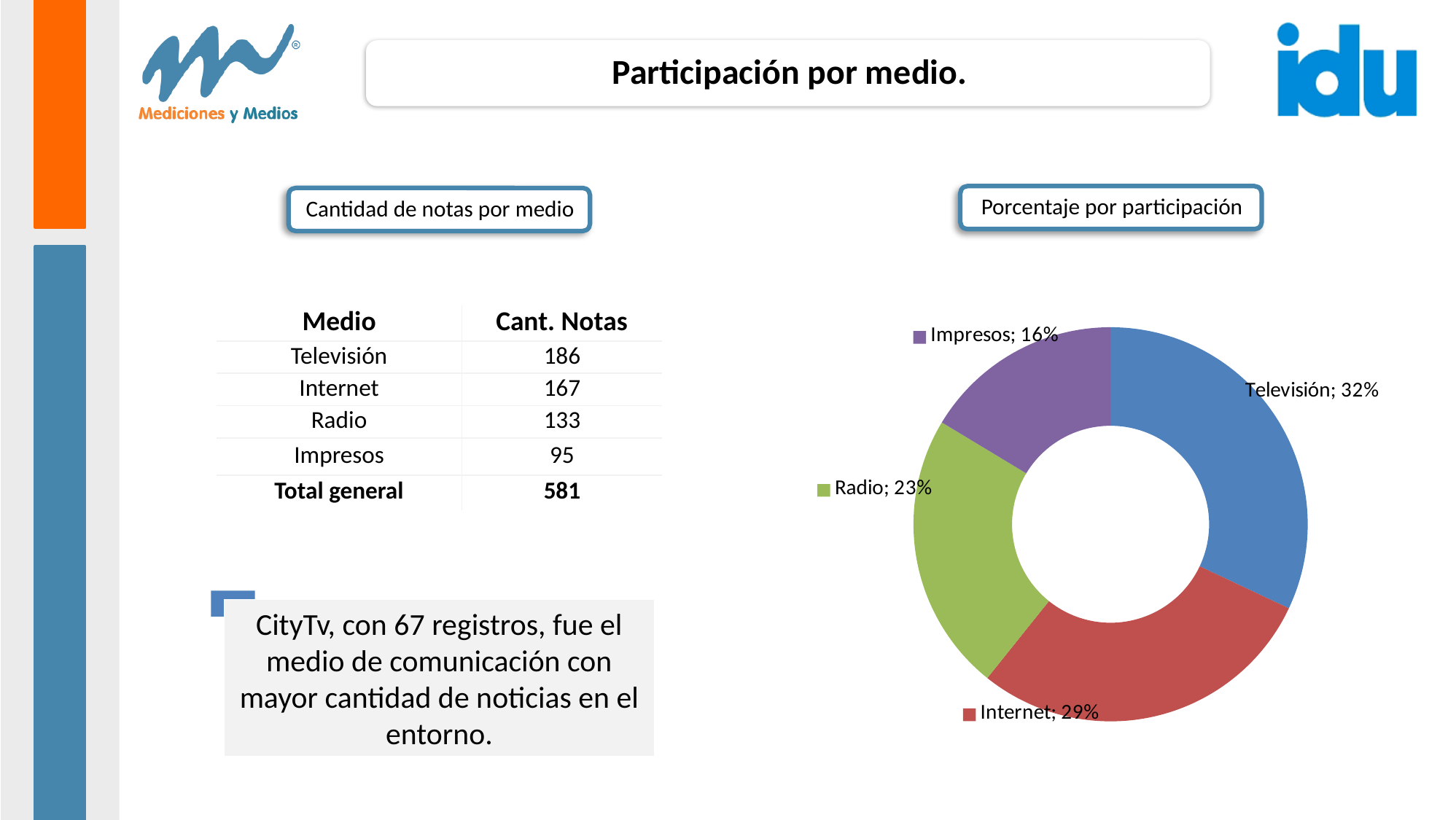
In the "Porcentaje por participación" chart, which medium has the largest share? Televisión In the "Porcentaje por participación" chart, how many slices are there? 4 In the "Porcentaje por participación" chart, what is the share for Radio? 23% In the "Porcentaje por participación" chart, what colour is the Radio slice? green In the "Porcentaje por participación" chart, which is larger, the share for Radio or the share for Internet? Internet In the "Porcentaje por participación" chart, what is the difference in percentage points between Internet and Radio? 6 In the "Porcentaje por participación" chart, which medium has the smallest share? Impresos In the "Porcentaje por participación" chart, what is the share for Impresos? 16% What kind of chart is shown under "Porcentaje por participación"? doughnut chart In the "Porcentaje por participación" chart, what is the share for Televisión? 32% In the "Porcentaje por participación" chart, what is the share for Internet? 29% In the "Porcentaje por participación" chart, what is the difference in percentage points between Televisión and Impresos? 16